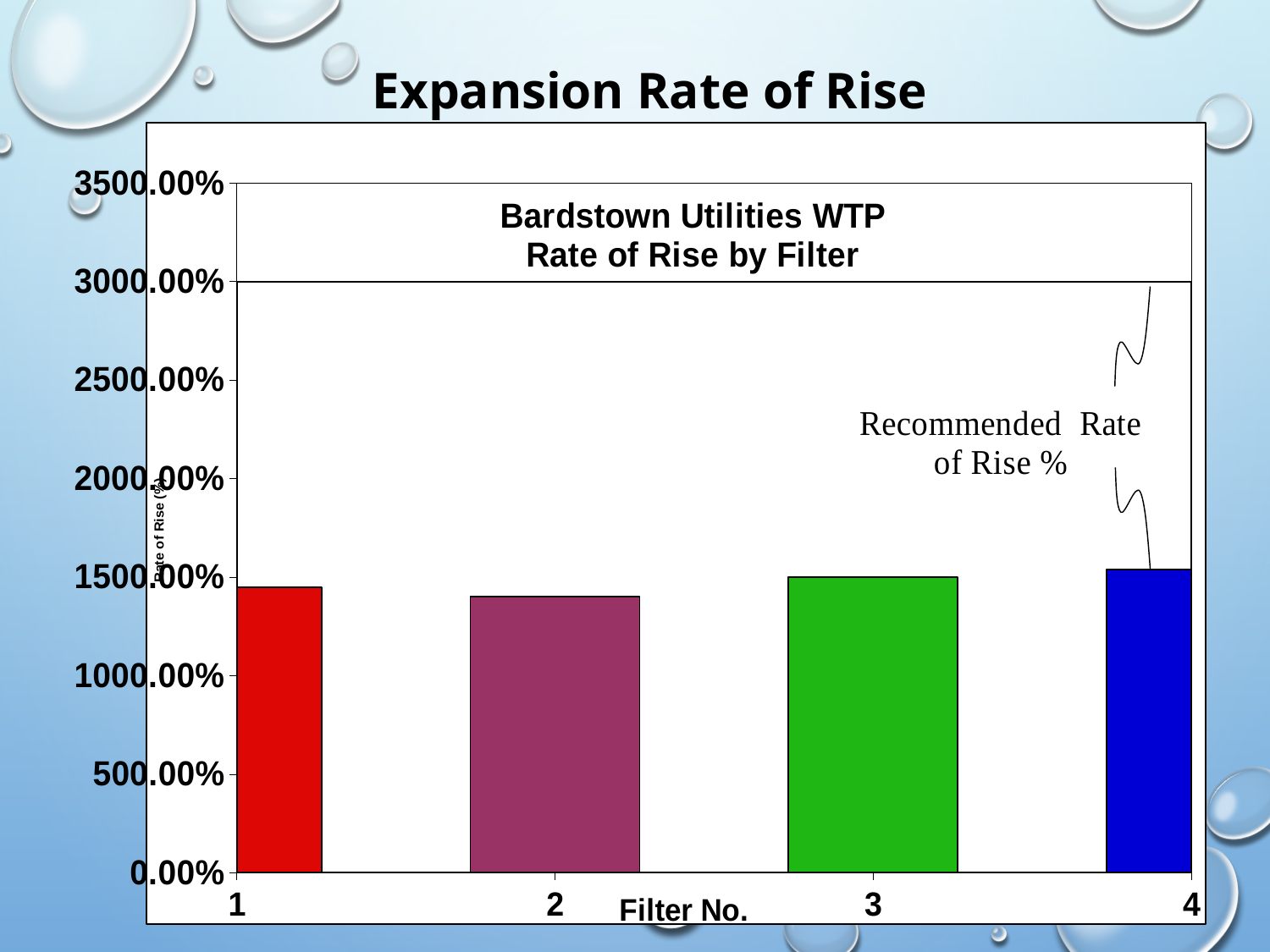
Is the rate of rise for Filter 2 greater or less than 1500.00%? less Which has a higher rate of rise, Filter 3 or Filter 4? Filter 4 Is the rate of rise for Filter 1 greater or less than 1500.00%? less Which filter has the highest rate of rise? 4 Which filter has the lowest rate of rise? 2 How many filters are plotted on the chart? 4 Is the rate of rise for Filter 2 greater or less than 1000.00%? greater What is the label of the x axis? Filter No. What is the title printed inside the chart area? Bardstown Utilities WTP Rate of Rise by Filter What kind of chart is shown on the slide? bar chart Which has a higher rate of rise, Filter 1 or Filter 2? Filter 1